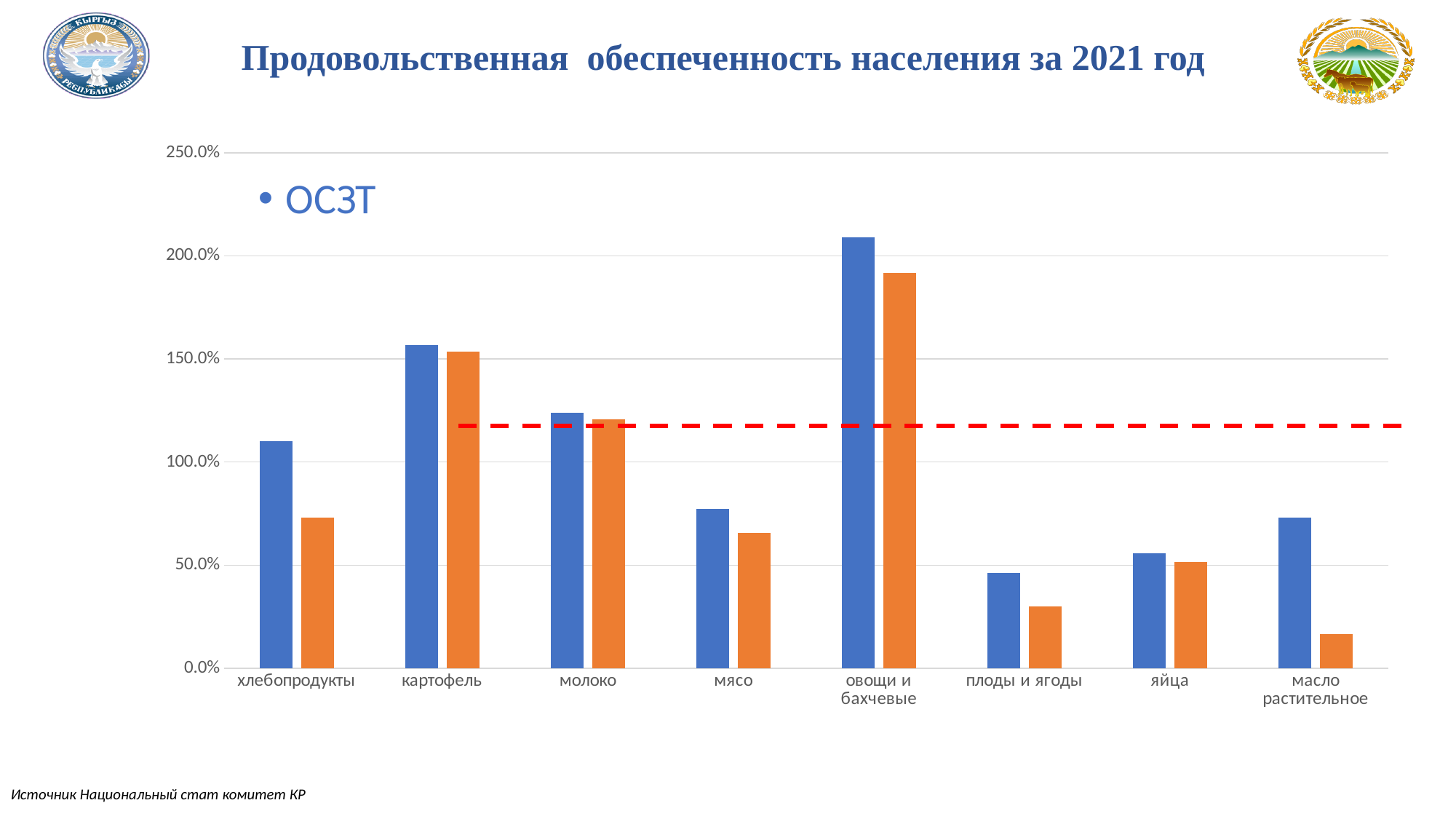
What is the title of the slide containing the chart? Продовольственная обеспеченность населения за 2021 год What kind of chart is shown on the slide? bar chart Which blue bar is larger, мясо or яйца? мясо Which category has the highest blue bar? овощи и бахчевые How many product categories are shown on the x axis? 8 Is the orange bar for плоды и ягоды greater or less than 50.0%? less Is the orange bar for хлебопродукты greater or less than 100.0%? less Is the blue bar for овощи и бахчевые greater or less than 200.0%? greater For масло растительное, which bar is larger, the blue one or the orange one? the blue one Which category has the lowest blue bar? плоды и ягоды Which category has the lowest orange bar? масло растительное